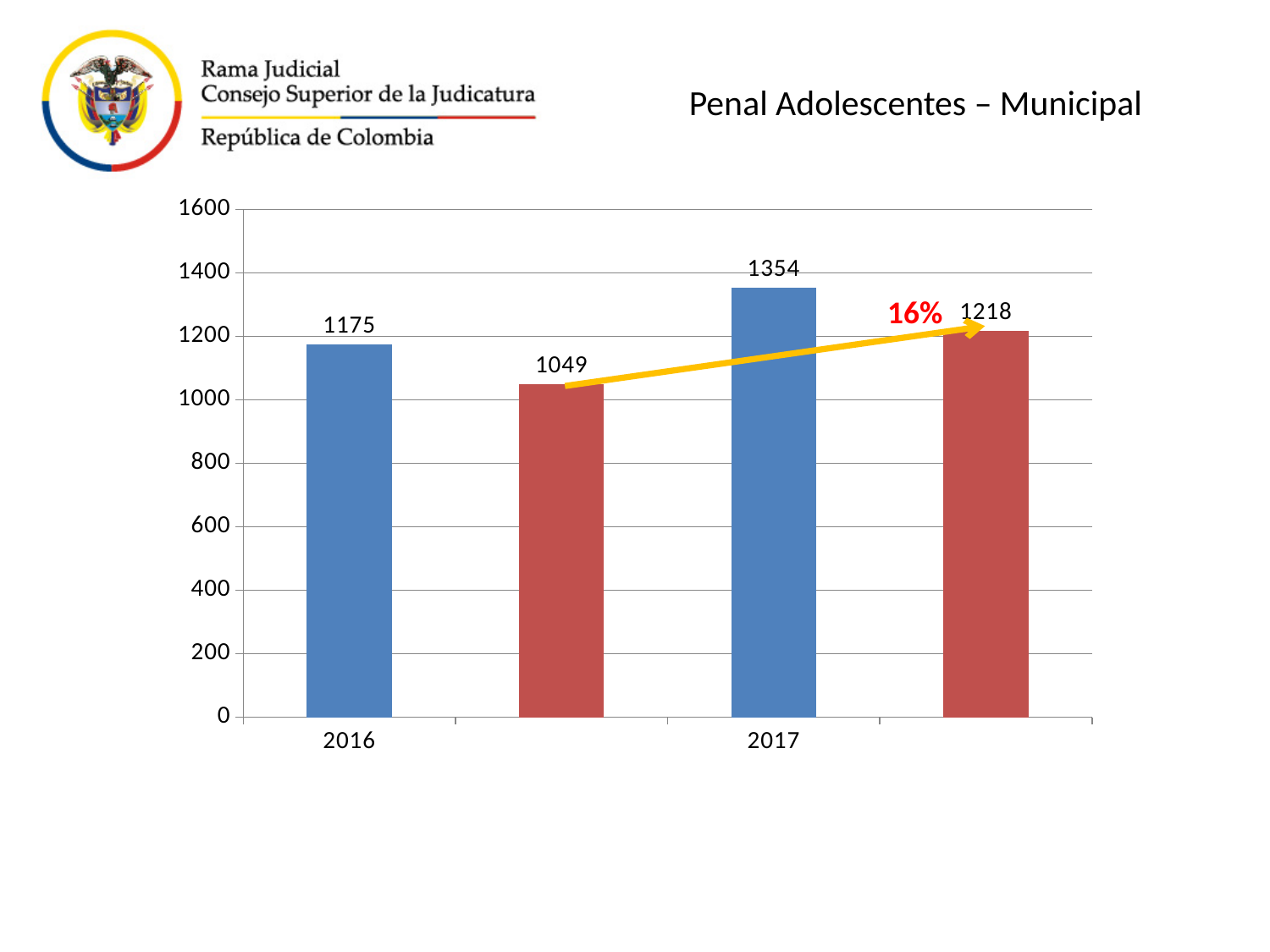
What is the difference between the red bar values for 2017 and 2016? 169 How many years are shown on the x axis? 2 Which bar has the highest value on the chart? The blue bar for 2017 (1354) What percentage is written next to the arrow connecting the red bars? 16% What kind of chart is shown on the slide? Bar chart What is the value of the blue bar for 2017? 1354 Which is larger, the blue bar for 2016 or the red bar for 2017? The red bar for 2017 What is the value of the red bar for 2016? 1049 What is the value of the blue bar for 2016? 1175 Which bar has the lowest value on the chart? The red bar for 2016 (1049) What is the difference between the blue bar values for 2017 and 2016? 179 What is the value of the red bar for 2017? 1218